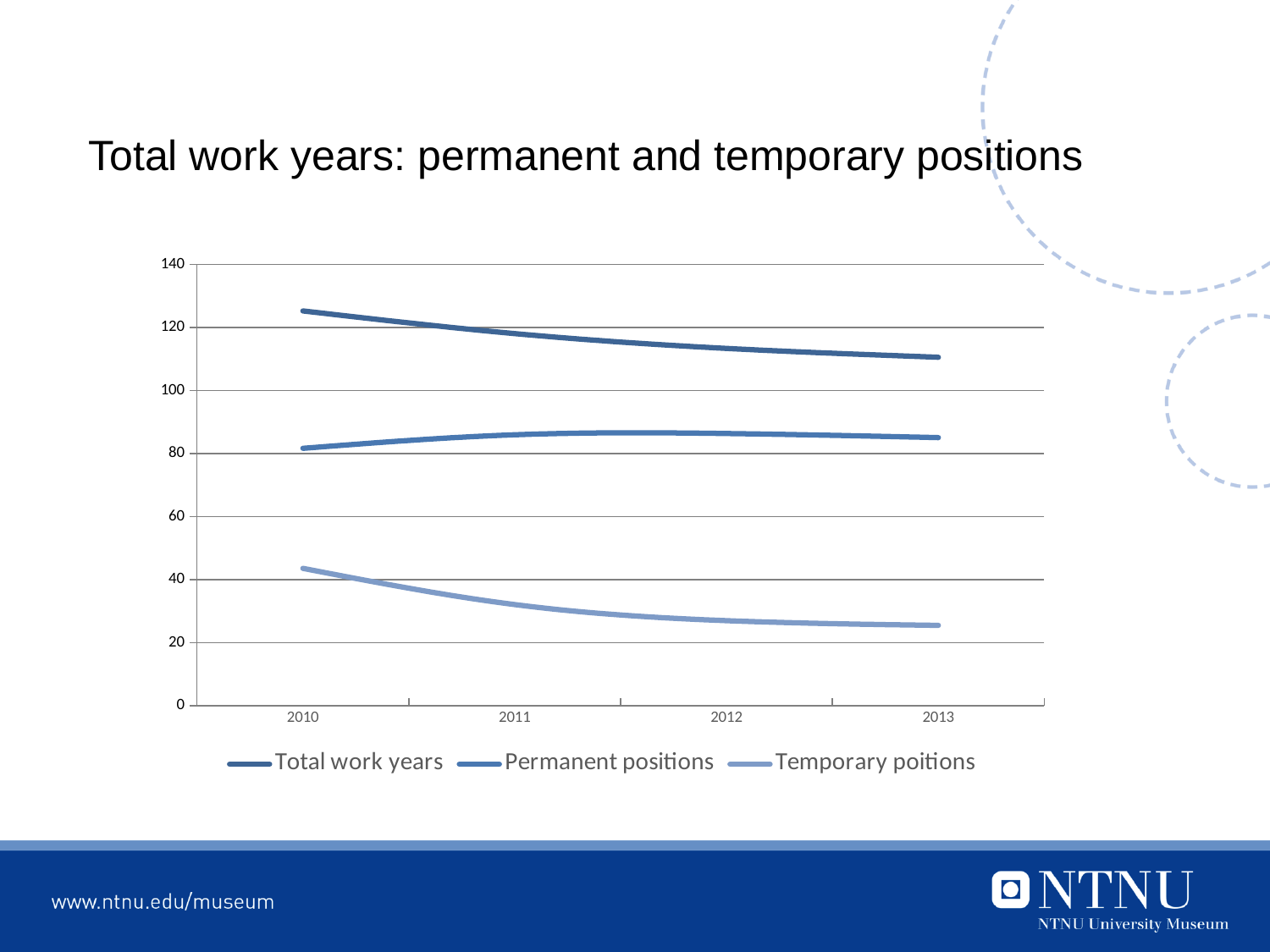
How many years are shown on the x axis? 4 Does the Temporary positions line rise or fall from 2010 to 2013? fall Is the value for Total work years in 2010 greater or less than 120? greater Is the value for Total work years in 2013 greater or less than 120? less What kind of chart is shown on the slide? line chart Is the value for Permanent positions in 2012 greater or less than 100? less Does the Total work years line rise or fall from 2010 to 2013? fall Which series has the highest value in 2010? Total work years How many series does the legend list? 3 In 2013, which is larger: Permanent positions or Temporary positions? Permanent positions Which series has the lowest value in 2013? Temporary positions